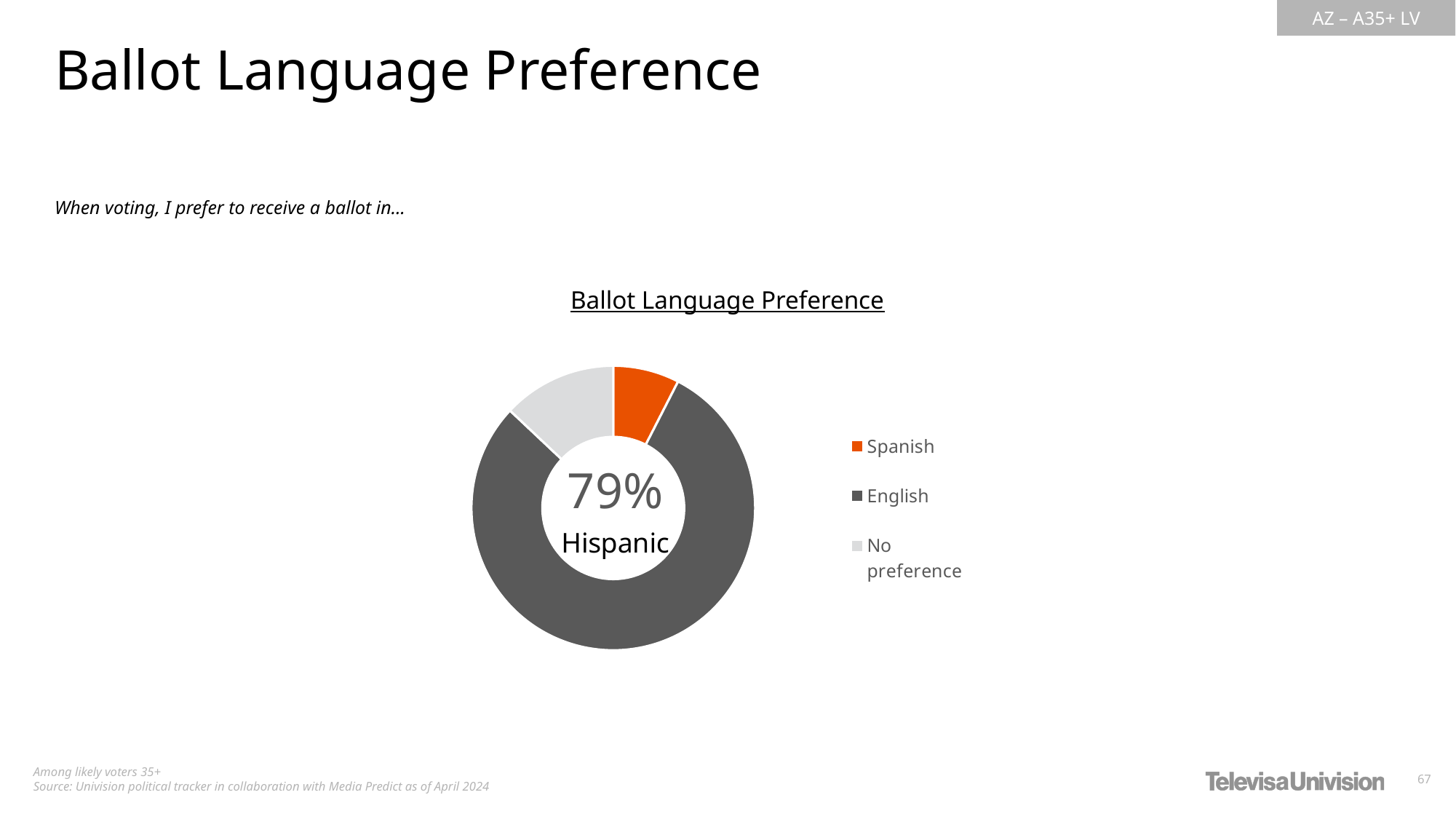
How many categories does the Ballot Language Preference chart show? 3 Which slice is larger, English or No preference? English What kind of chart is shown on the slide? Donut (pie) chart How many entries does the legend of the Ballot Language Preference chart list? 3 What is the title of the chart? Ballot Language Preference Which category has the smallest slice in the Ballot Language Preference chart? Spanish What percentage is printed in the centre of the donut chart? 79% Which slice is larger, Spanish or No preference? No preference Which category has the largest slice in the Ballot Language Preference chart? English